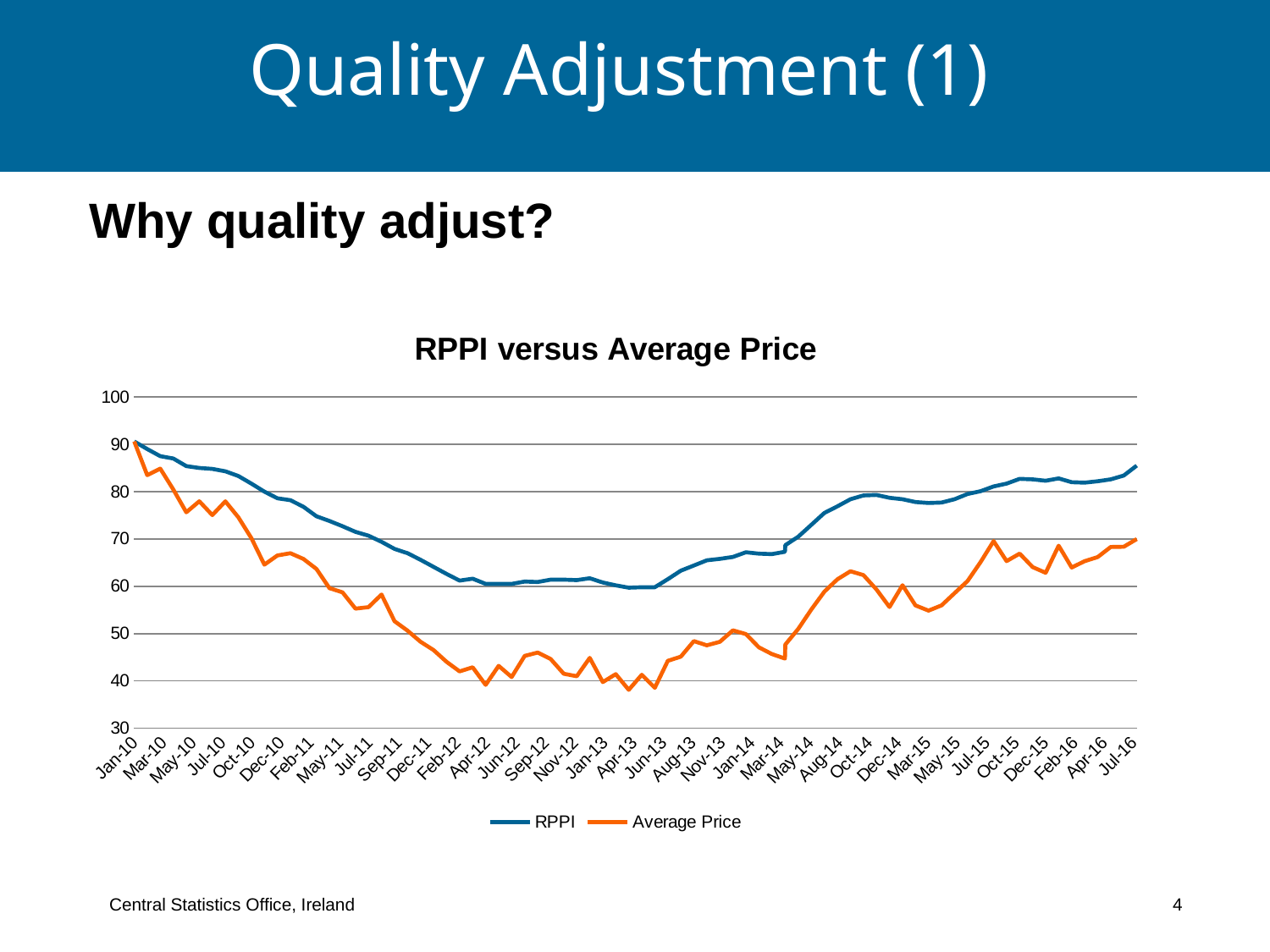
How many series does the legend of the chart list? 2 Is the value for RPPI at Jul-16 greater or less than 80? greater Is the value for Average Price at Jul-11 greater or less than 60? less Is the value for Average Price at Oct-14 greater or less than 60? greater Does the RPPI line rise or fall between Jan-10 and Apr-13? Fall What is the title of the chart? RPPI versus Average Price What kind of chart is shown on the slide? Line chart Which colour is used for the Average Price line? Orange Does the Average Price line rise or fall between Jun-13 and Jul-16? Rise At Jul-16, which series has the higher value, RPPI or Average Price? RPPI